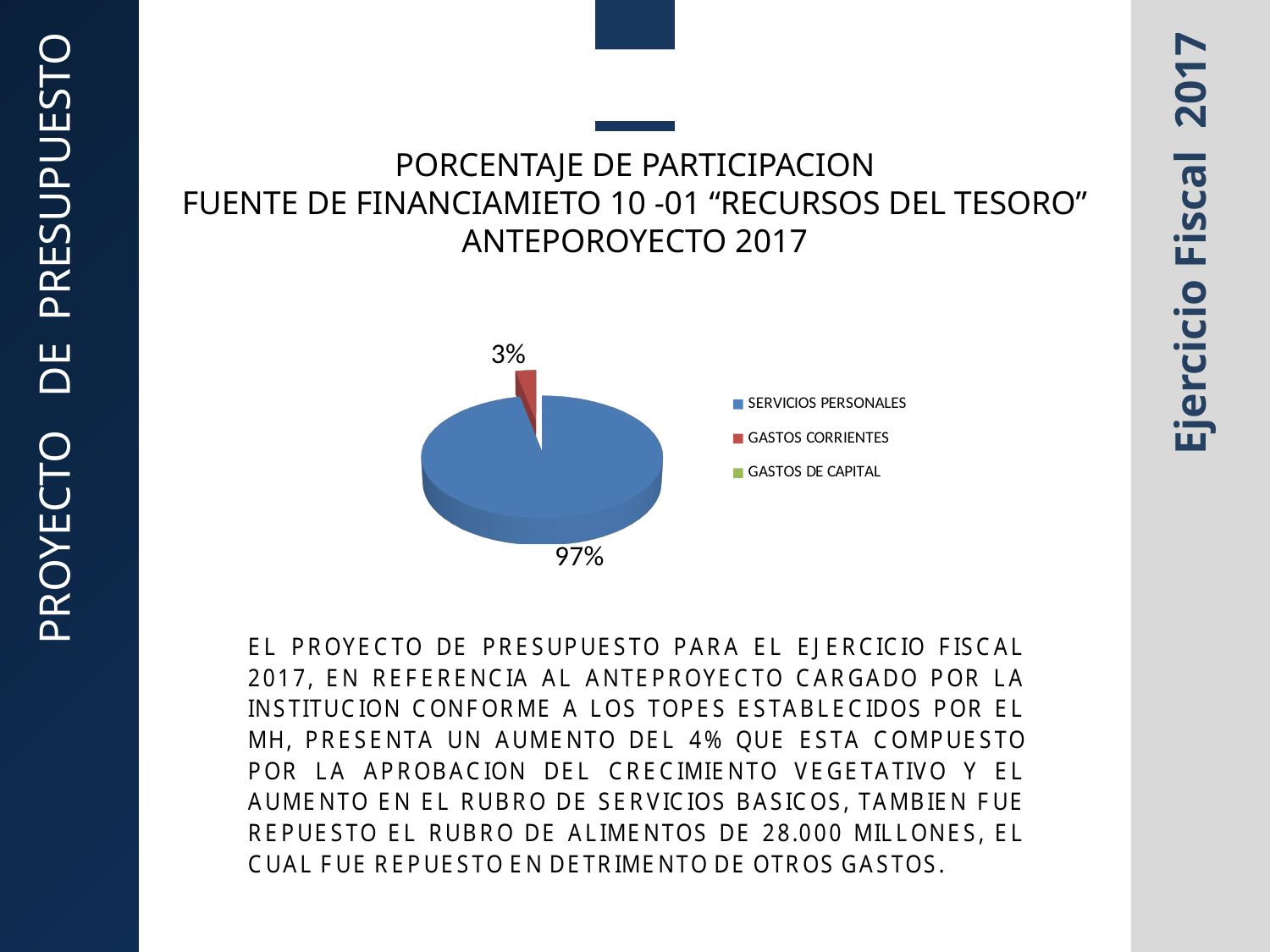
What colour is used for the SERVICIOS PERSONALES slice? Blue How many categories are listed in the chart's legend? 3 By how many percentage points does the SERVICIOS PERSONALES share exceed the GASTOS CORRIENTES share? 94 percentage points What share of the pie does SERVICIOS PERSONALES represent? 97% Which of the two labeled slices, SERVICIOS PERSONALES or GASTOS CORRIENTES, is smaller? GASTOS CORRIENTES Which is larger, the slice for SERVICIOS PERSONALES or the slice for GASTOS CORRIENTES? SERVICIOS PERSONALES What kind of chart is shown on the slide? Pie chart Which legend entry is shown in green? GASTOS DE CAPITAL Which category has the largest slice of the pie? SERVICIOS PERSONALES Is the share for SERVICIOS PERSONALES greater or less than 50%? greater What share of the pie does GASTOS CORRIENTES represent? 3%